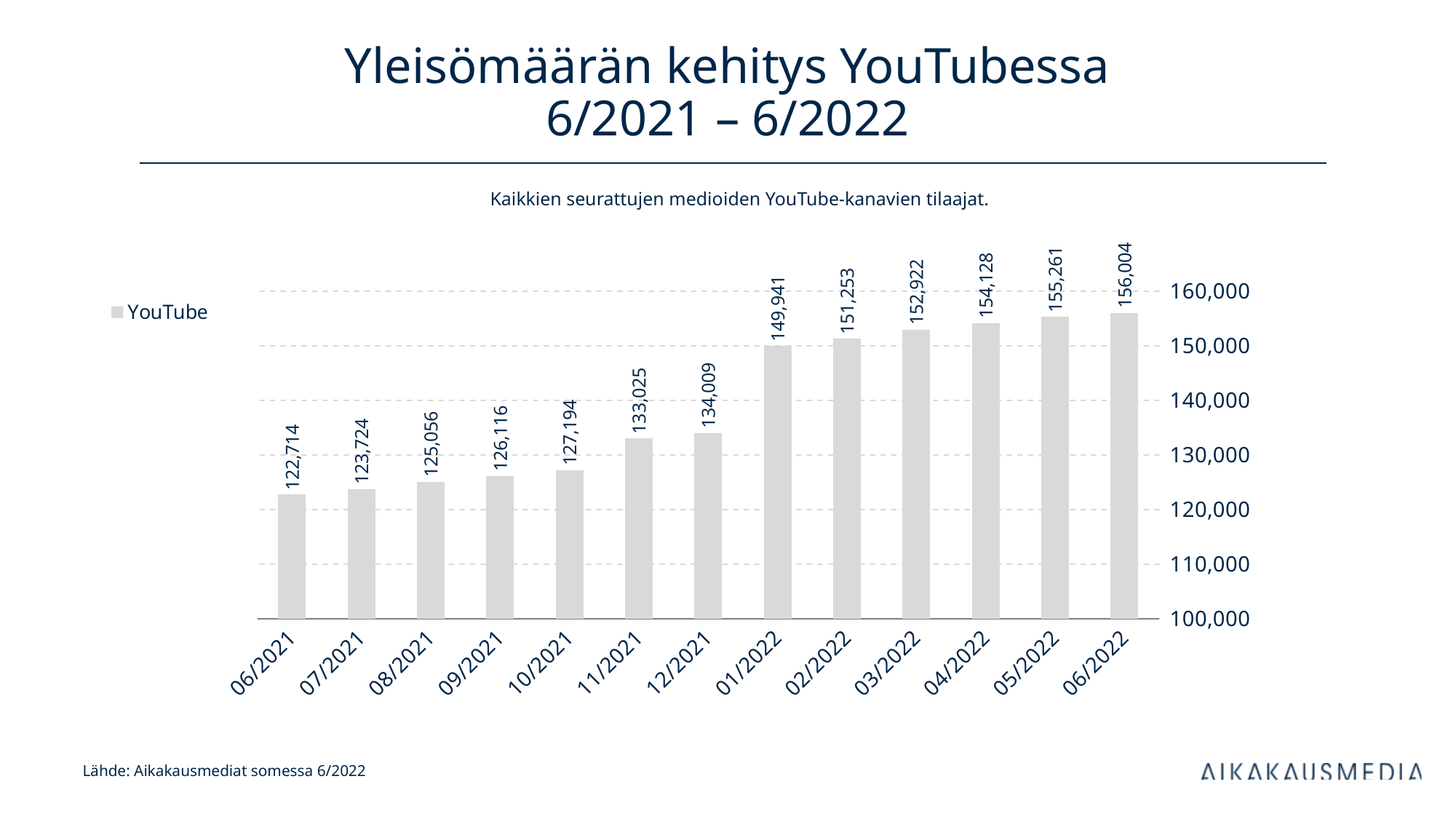
Which month has the lowest value? 06/2021 What is the value for 06/2022? 156,004 What is the difference between the values for 06/2022 and 06/2021? 33,290 What is the difference between the values for 01/2022 and 12/2021? 15,932 How many series does the legend list? 1 Which month has the highest value? 06/2022 What is the value for 01/2022? 149,941 Do the values rise or fall from 06/2021 to 06/2022? rise What is the value for 06/2021? 122,714 Which is larger, the value for 11/2021 or the value for 03/2022? 03/2022 How many months are shown on the x axis? 13 What kind of chart is shown on the slide? bar chart